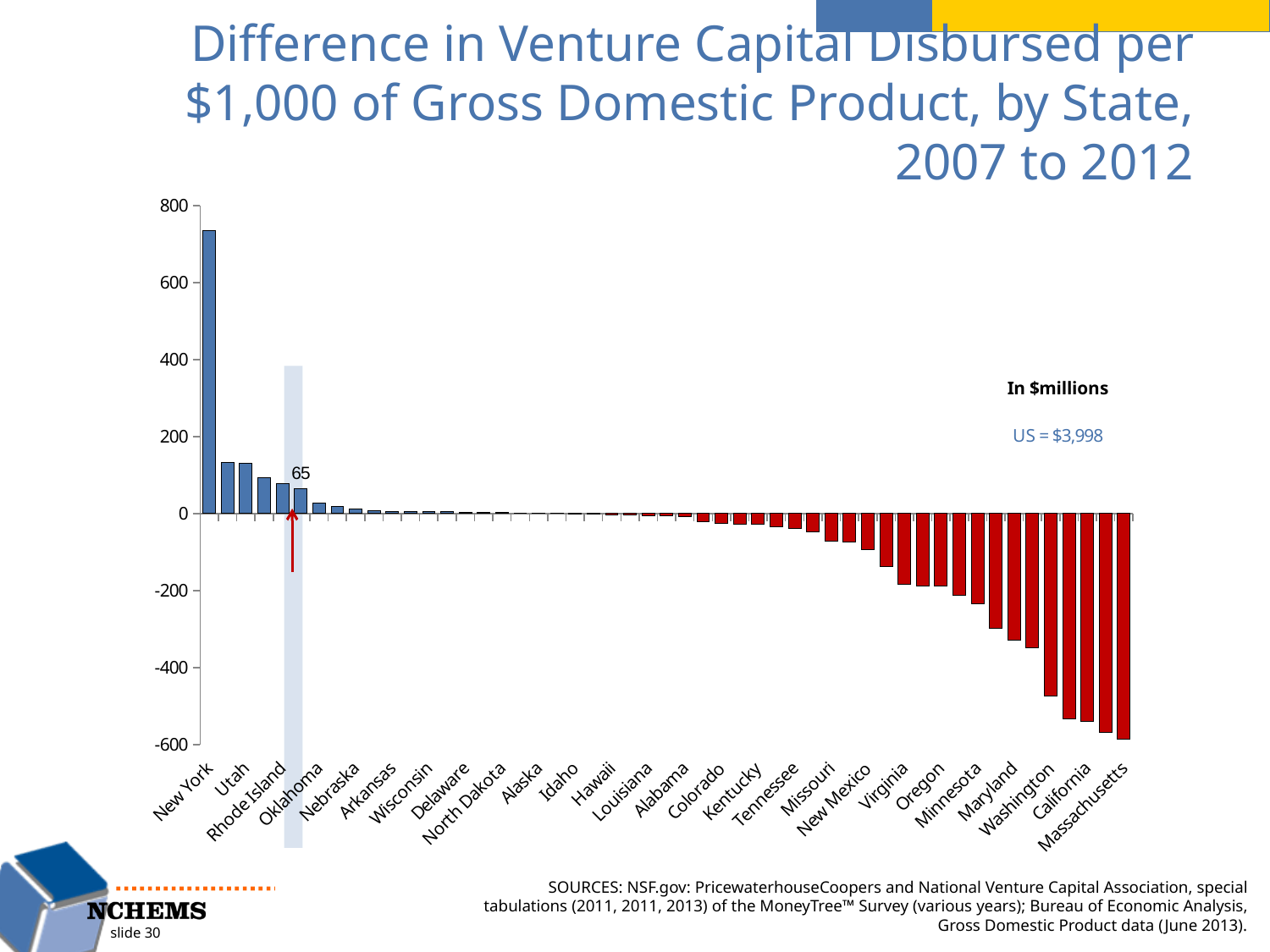
Which has the larger value, Oklahoma or Massachusetts? Oklahoma Is the value for Massachusetts greater or less than -400? less Is the value for New York greater or less than 600? greater Which state has the lowest value in the chart? Massachusetts What kind of chart is shown on the slide? bar chart What US total value is noted on the chart? US = $3,998 Do the values rise or fall moving from left to right across the states? fall Which state has the highest value in the chart? New York Is the value for California greater or less than -400? less Which has the larger value, Utah or Oklahoma? Utah